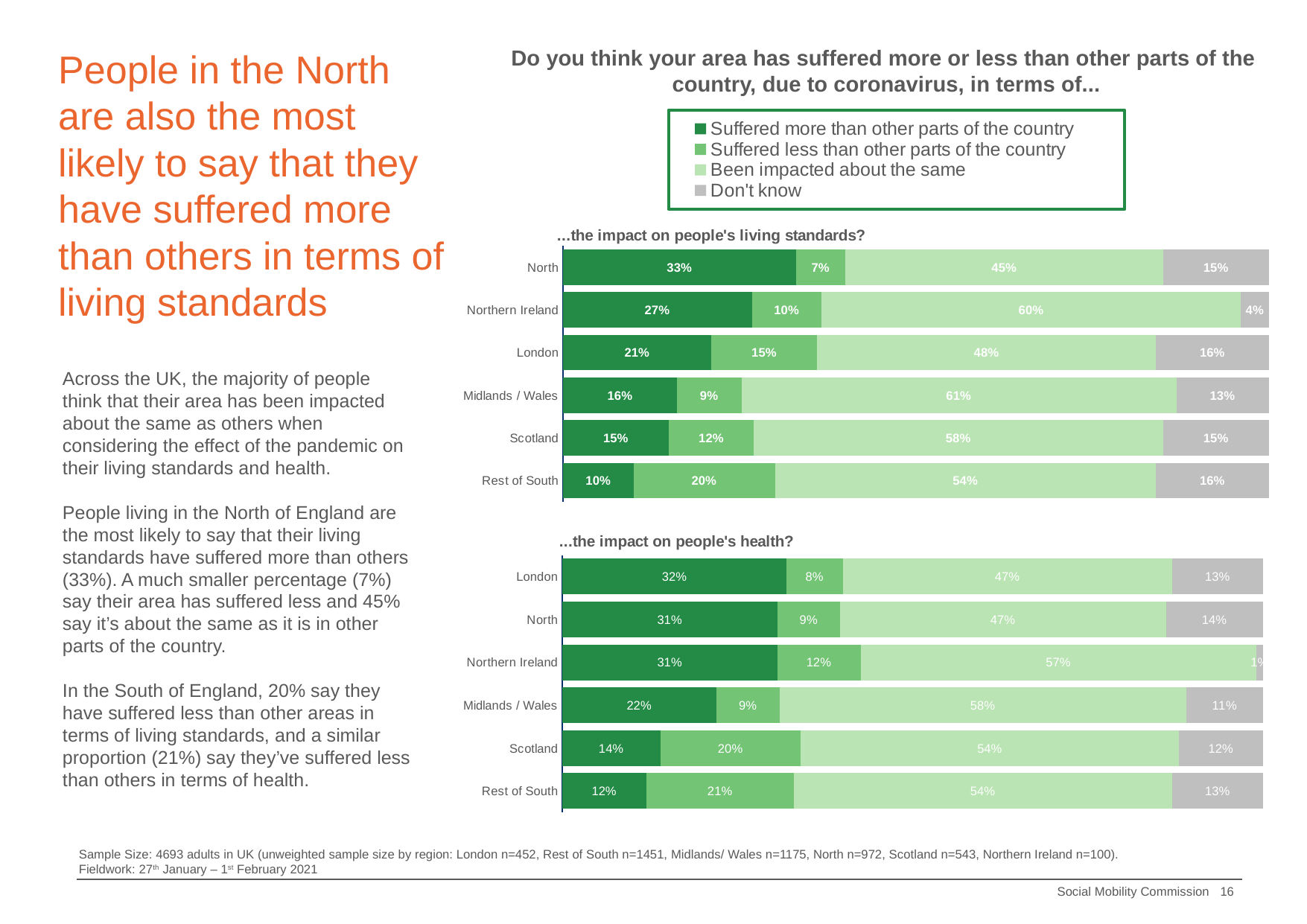
In the chart '…the impact on people's living standards?', what percentage of people in the North said their area suffered more than other parts of the country? 33% In the chart '…the impact on people's health?', what is the difference between the 'Suffered more' percentages for London and Midlands / Wales? 10% How many regions are shown in the chart '…the impact on people's living standards?'? 6 How many series does the legend list for the charts on this slide? 4 In the chart '…the impact on people's health?', what percentage of people in Scotland said their area suffered less than other parts of the country? 20% In the chart '…the impact on people's health?', which region has the lowest share saying their area suffered more than other parts of the country? Rest of South In the chart '…the impact on people's living standards?', what is the 'Don't know' percentage for Northern Ireland? 4% In the chart '…the impact on people's living standards?', which region has the highest share saying they have been impacted about the same? Midlands / Wales What type of chart is used for '…the impact on people's health?'? Stacked bar chart In the chart '…the impact on people's living standards?', which region has the lowest share saying their area suffered more than other parts of the country? Rest of South In the chart '…the impact on people's living standards?', what is the difference between the 'Suffered more' percentages for the North and Northern Ireland? 6% In the chart '…the impact on people's health?', is the 'Been impacted about the same' share larger for Midlands / Wales or for London? Midlands / Wales